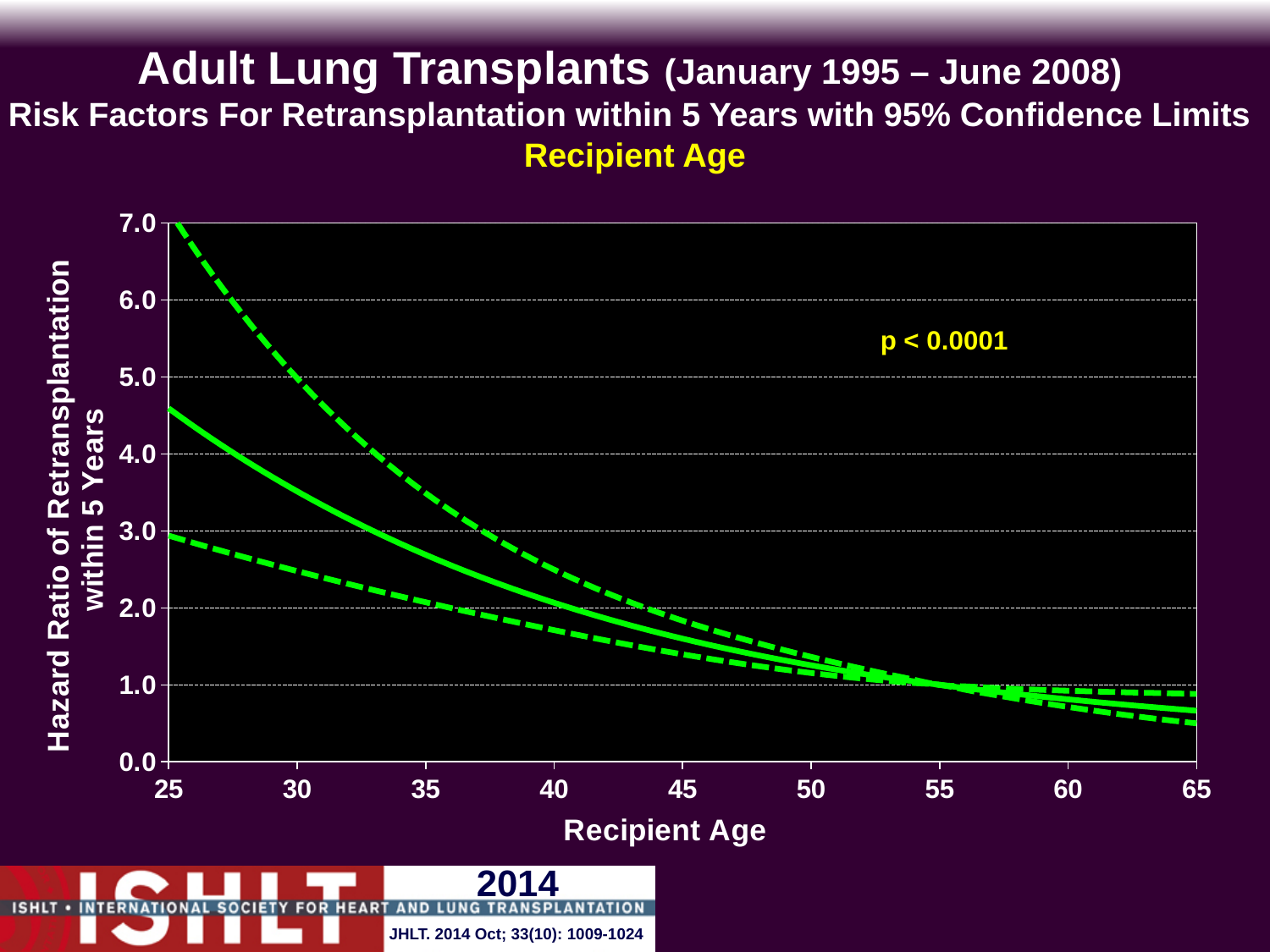
How many lines are plotted on the chart? 3 Is the hazard ratio (solid line) at recipient age 65 greater or less than 1.0? less Is the upper 95% confidence limit (upper dashed line) at recipient age 30 greater or less than 4.0? greater Is the hazard ratio (solid line) at recipient age 25 greater or less than 4.0? greater What is the label of the x axis? Recipient Age Does the hazard ratio of retransplantation rise or fall as recipient age increases along the x axis? fall What p-value is printed on the chart? p < 0.0001 What kind of chart is shown on the slide? line chart Is the hazard ratio (solid line) higher at recipient age 25 or at recipient age 45? 25